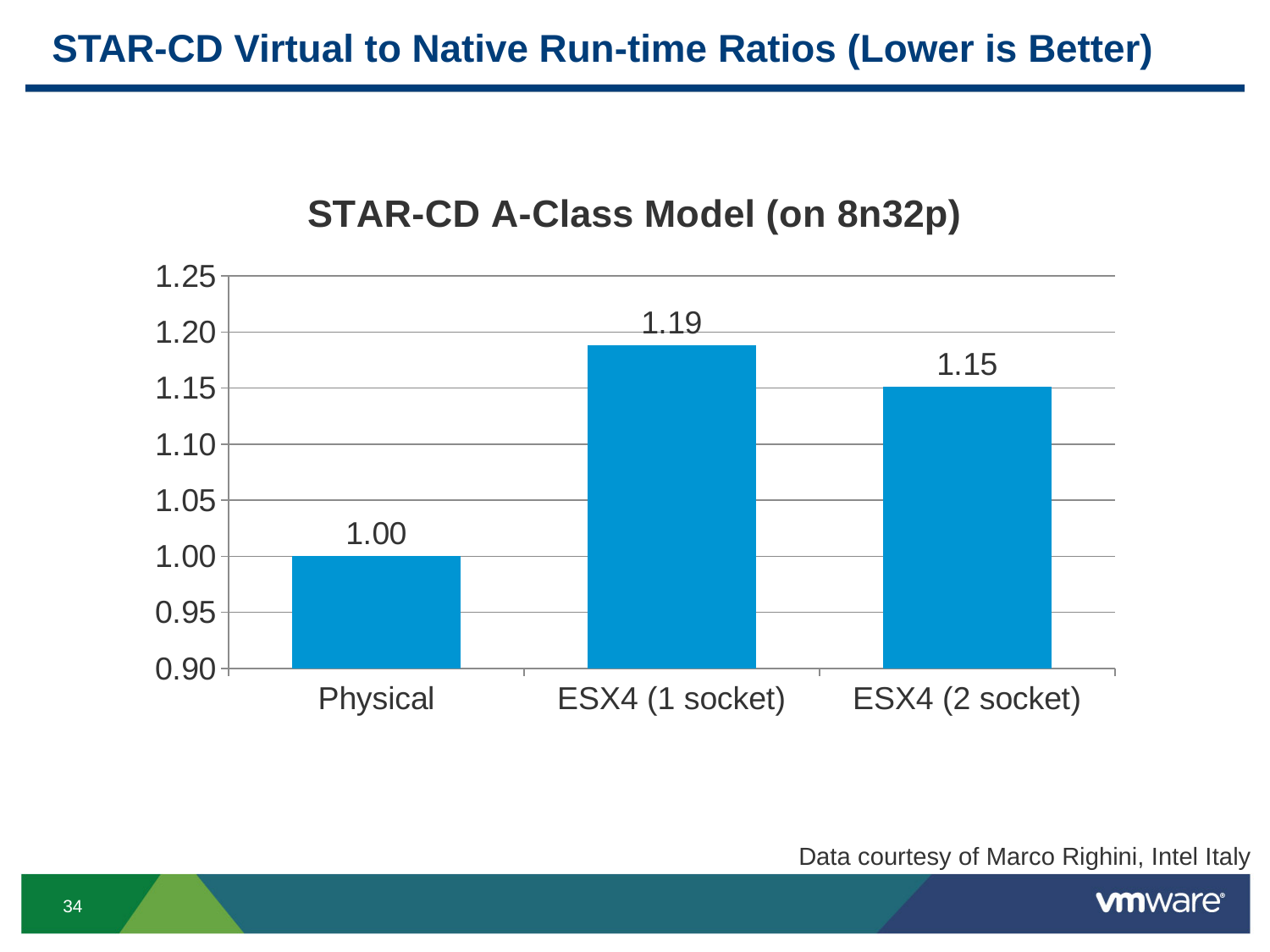
Which category has the lowest value? Physical What is the difference between the values for ESX4 (2 socket) and Physical? 0.15 How many categories are shown on the x axis? 3 Is the value for ESX4 (2 socket) greater or less than 1.10? greater What is the value for ESX4 (2 socket)? 1.15 What is the title of the chart? STAR-CD A-Class Model (on 8n32p) What is the value for Physical? 1.00 Which category has the highest value? ESX4 (1 socket) What is the difference between the values for ESX4 (1 socket) and ESX4 (2 socket)? 0.04 What is the value for ESX4 (1 socket)? 1.19 Which is larger, the value for ESX4 (1 socket) or ESX4 (2 socket)? ESX4 (1 socket) What kind of chart is this? bar chart